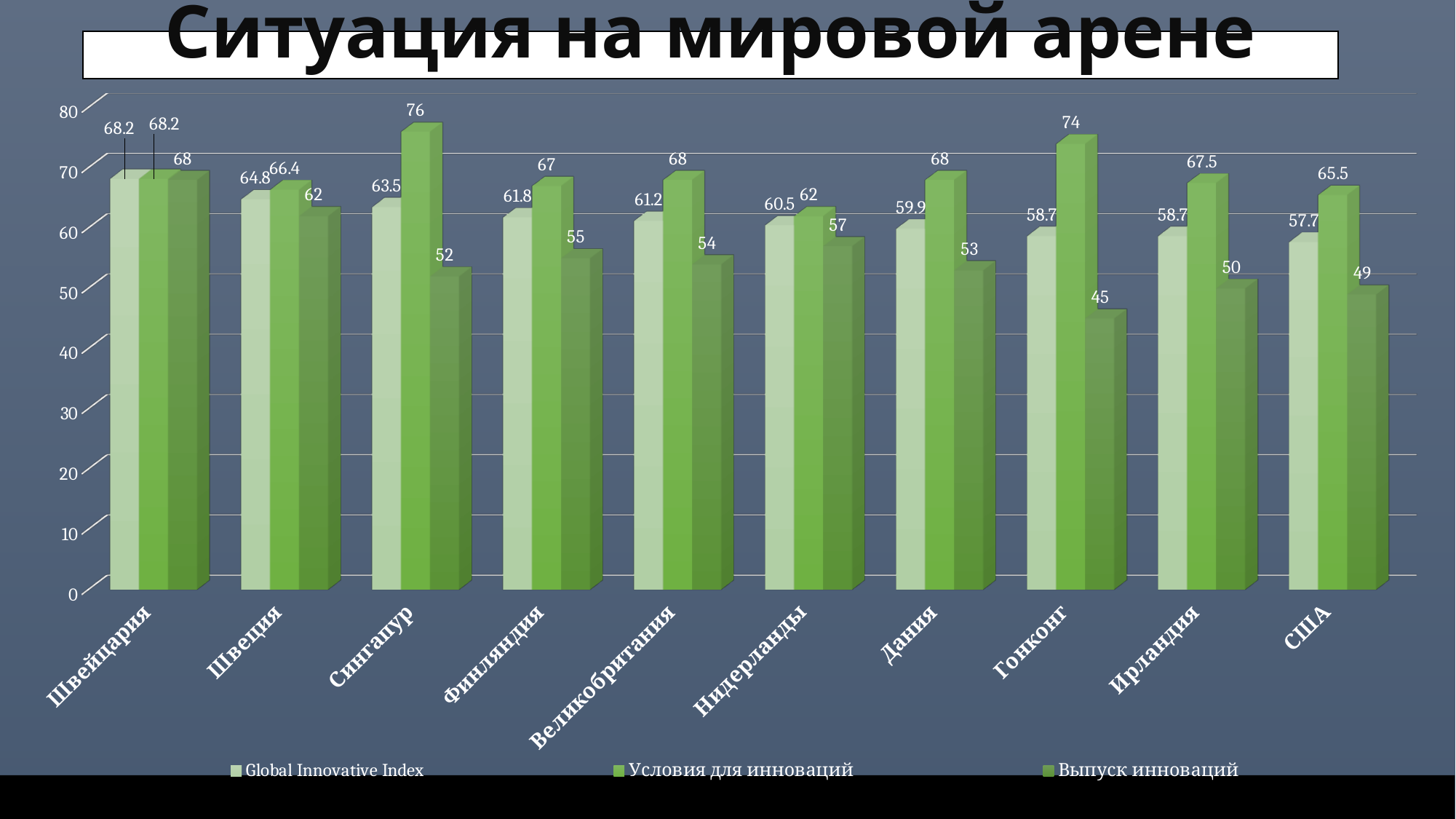
How many countries are shown on the x axis? 10 What kind of chart is shown on the slide? Bar chart Which country has the lowest value for Выпуск инноваций? Гонконг What is the Global Innovative Index value for Сингапур? 63.5 Which country has the highest value for Условия для инноваций? Сингапур What is the value of Выпуск инноваций for Нидерланды? 57 Which country has the lowest Global Innovative Index value? США Do the Global Innovative Index values rise or fall from Швейцария to США along the x axis? Fall What is the value of Условия для инноваций for Гонконг? 74 What is the difference between the Условия для инноваций and Выпуск инноваций values for Сингапур? 24 Which is larger: the Global Innovative Index for Швеция or for Финляндия? Швеция How many series does the legend list? 3